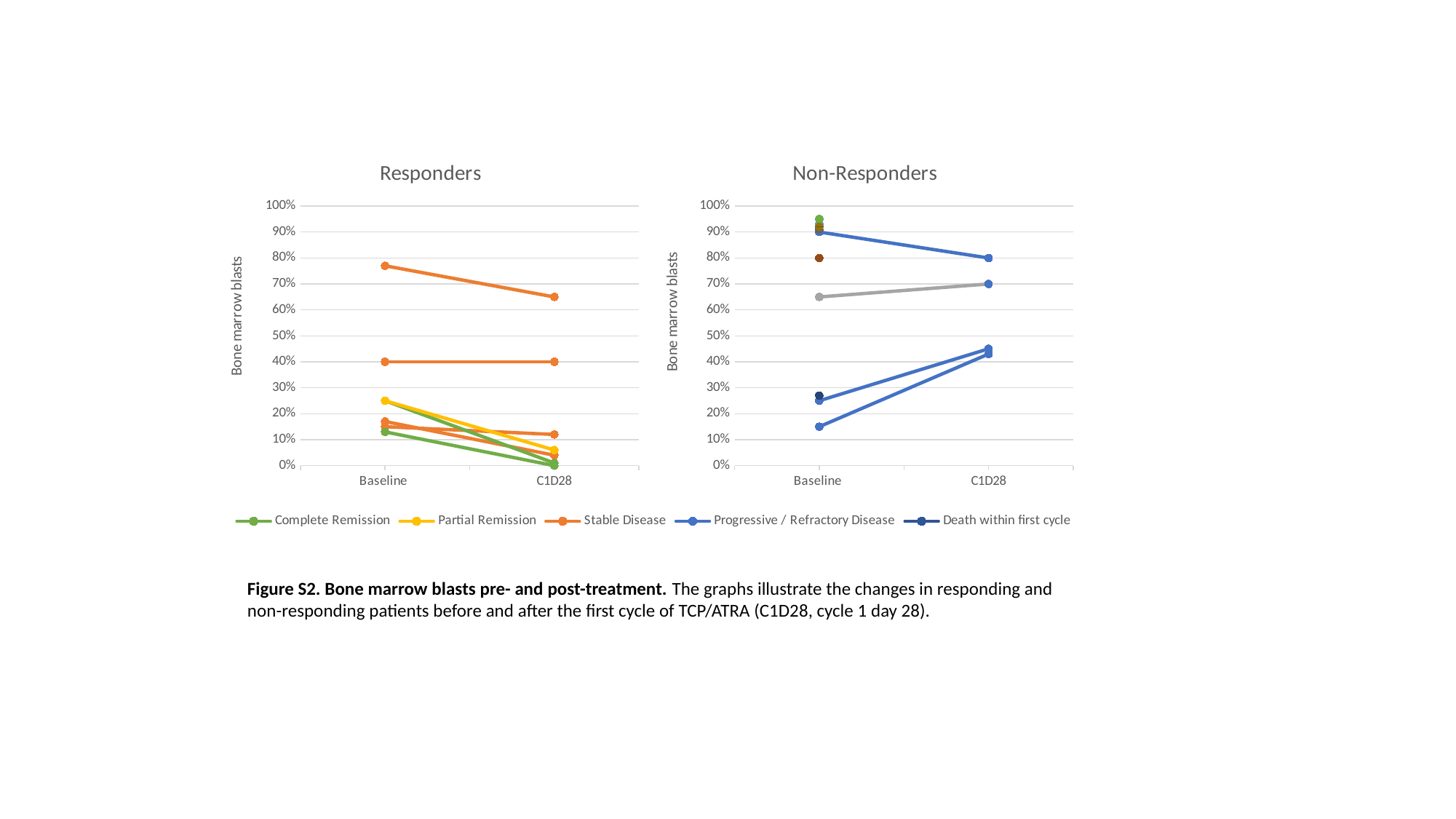
In the Responders chart, is the Complete Remission line at C1D28 greater or less than 10%? less How many series does the shared legend list? 5 In the Non-Responders chart, does the grey line rise or fall from Baseline to C1D28? rise In the Non-Responders chart, what value does the highest Progressive / Refractory Disease line reach at C1D28? 80% What is the y-axis label on the Responders chart? Bone marrow blasts What type of chart is the Responders chart? line chart In the Responders chart, is the Partial Remission line at Baseline greater or less than 20%? greater How many x-axis categories does the Non-Responders chart have? 2 In the Non-Responders chart, is the lowest Progressive / Refractory Disease point at Baseline greater or less than 20%? less In the Responders chart, does the highest Stable Disease line rise or fall from Baseline to C1D28? fall What is the title of the right-hand chart? Non-Responders